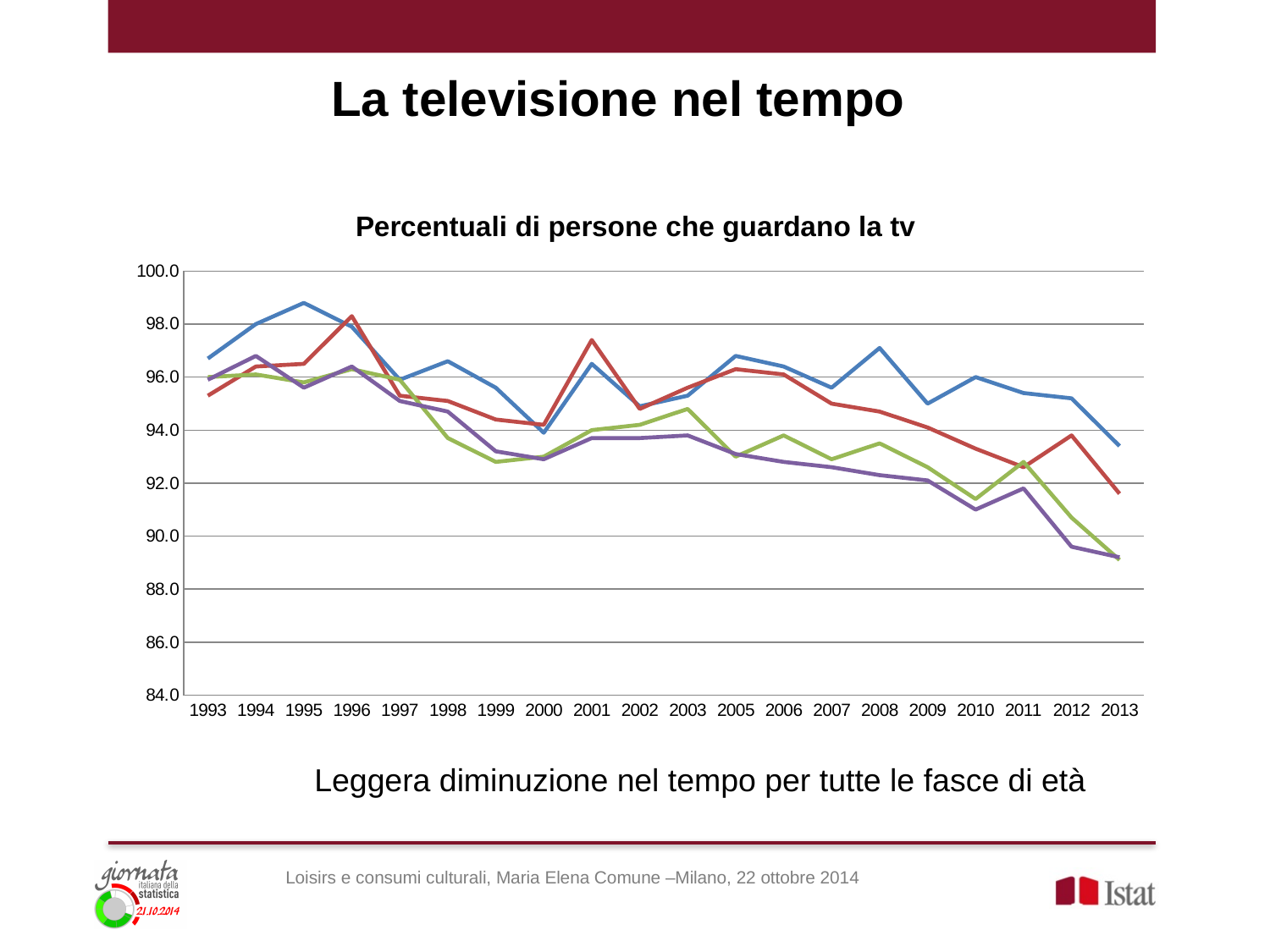
What kind of chart is shown on the slide? line chart What is the title of the chart? Percentuali di persone che guardano la tv In 2013, which line has the highest value? the blue line Is the value of the blue line in 1995 greater or less than 98.0? greater Is the value of the purple line in 2010 greater or less than 92.0? less Is the value of the blue line in 2013 greater or less than 94.0? less In 2008, which is higher: the blue line or the purple line? the blue line Overall, do the lines rise or fall from 1993 to 2013? fall How many years are shown on the x axis of the chart? 20 How many lines are plotted on the chart? 4